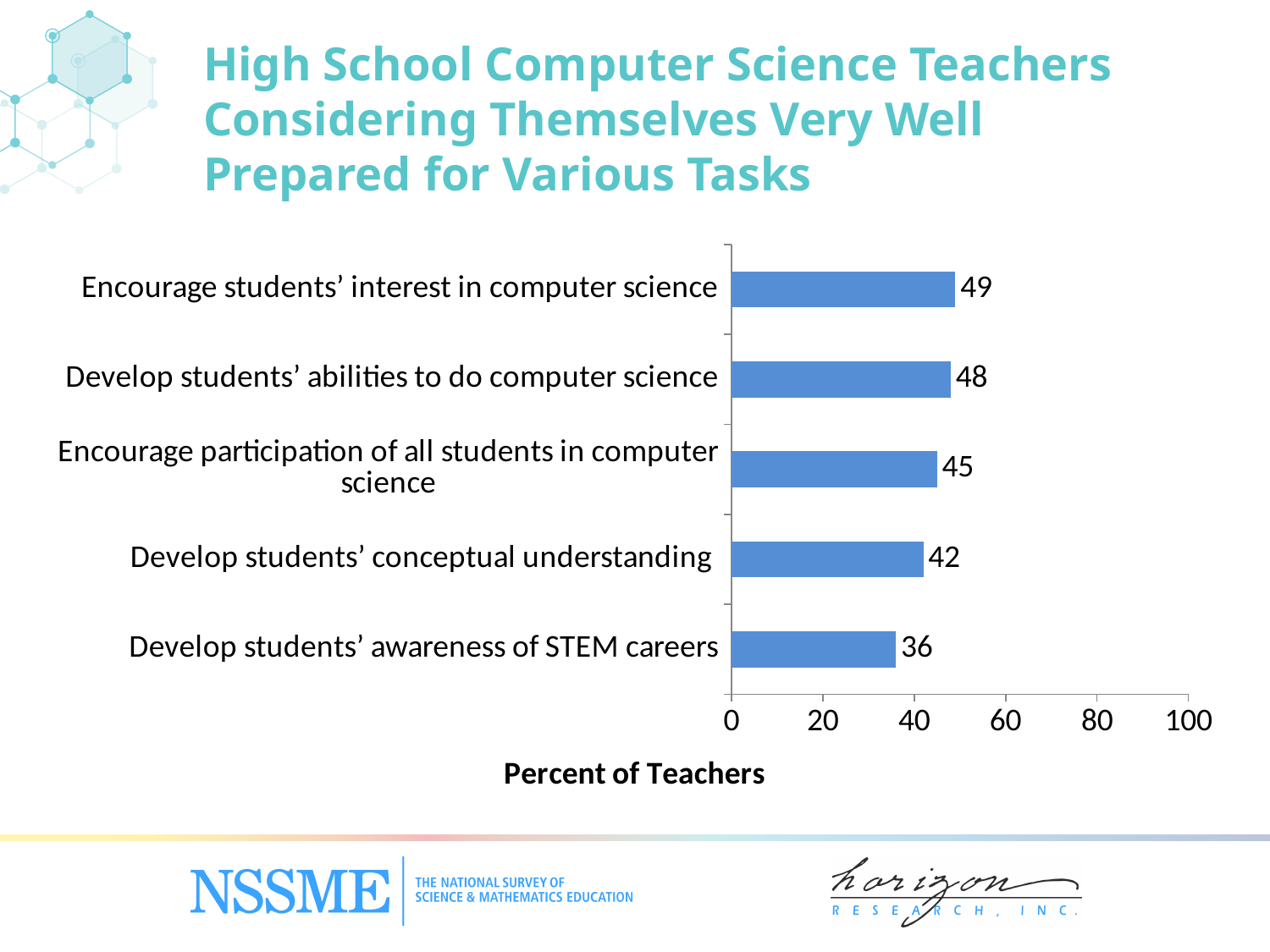
Is the value for 'Develop students' abilities to do computer science' greater or less than 40? greater What is the label of the horizontal axis? Percent of Teachers What percent of teachers consider themselves very well prepared to encourage students' interest in computer science? 49 Which is larger: the value for 'Develop students' conceptual understanding' or the value for 'Develop students' awareness of STEM careers'? Develop students' conceptual understanding What kind of chart is shown on the slide? bar chart Which task has the highest percent of teachers? Encourage students' interest in computer science What is the value for 'Encourage participation of all students in computer science'? 45 What is the difference between the values for 'Encourage students' interest in computer science' and 'Develop students' awareness of STEM careers'? 13 Which task has the lowest percent of teachers? Develop students' awareness of STEM careers What is the maximum value shown on the horizontal axis? 100 How many tasks are shown in the chart? 5 What is the value for 'Develop students' awareness of STEM careers'? 36